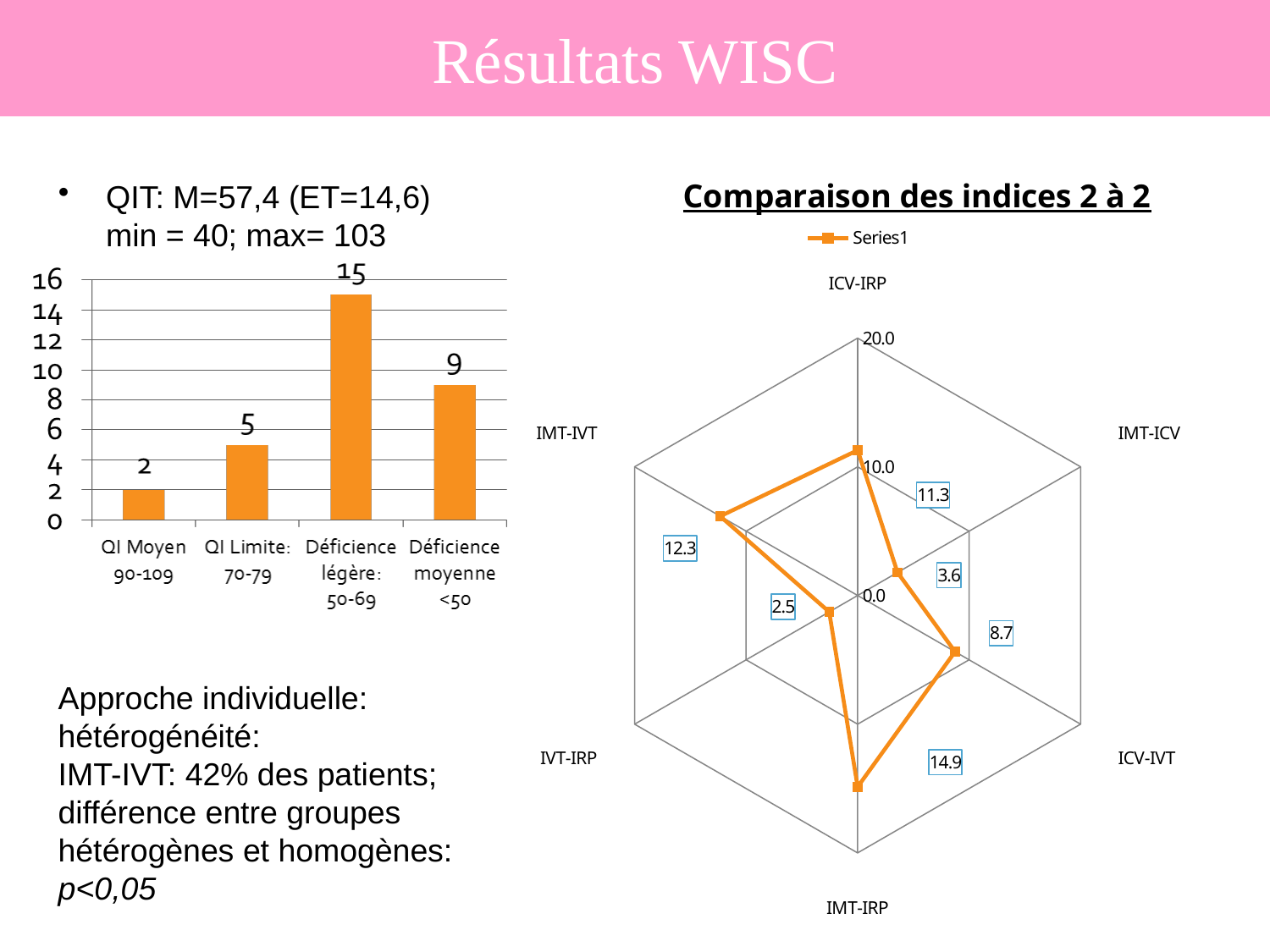
In the chart 'Comparaison des indices 2 à 2', which index pair has the highest value? IMT-IRP In the chart 'Comparaison des indices 2 à 2', what is the value for IVT-IRP? 2.5 How many categories are shown in the bar chart on the left? 4 In the chart 'Comparaison des indices 2 à 2', what is the value for IMT-IRP? 14.9 In the bar chart on the left, what is the value for 'QI Moyen 90-109'? 2 How many series does the legend of the chart 'Comparaison des indices 2 à 2' list? 1 What type of chart is the chart on the left of the slide? Bar chart In the bar chart on the left, which category has the highest value? Déficience légère: 50-69 In the bar chart on the left, what is the difference between the values for 'Déficience légère: 50-69' and 'Déficience moyenne <50'? 6 In the bar chart on the left, how many patients are in the 'Déficience légère: 50-69' category? 15 In the bar chart on the left, which category has the lowest value? QI Moyen 90-109 In the bar chart on the left, which is larger: the value for 'QI Limite: 70-79' or for 'Déficience moyenne <50'? Déficience moyenne <50